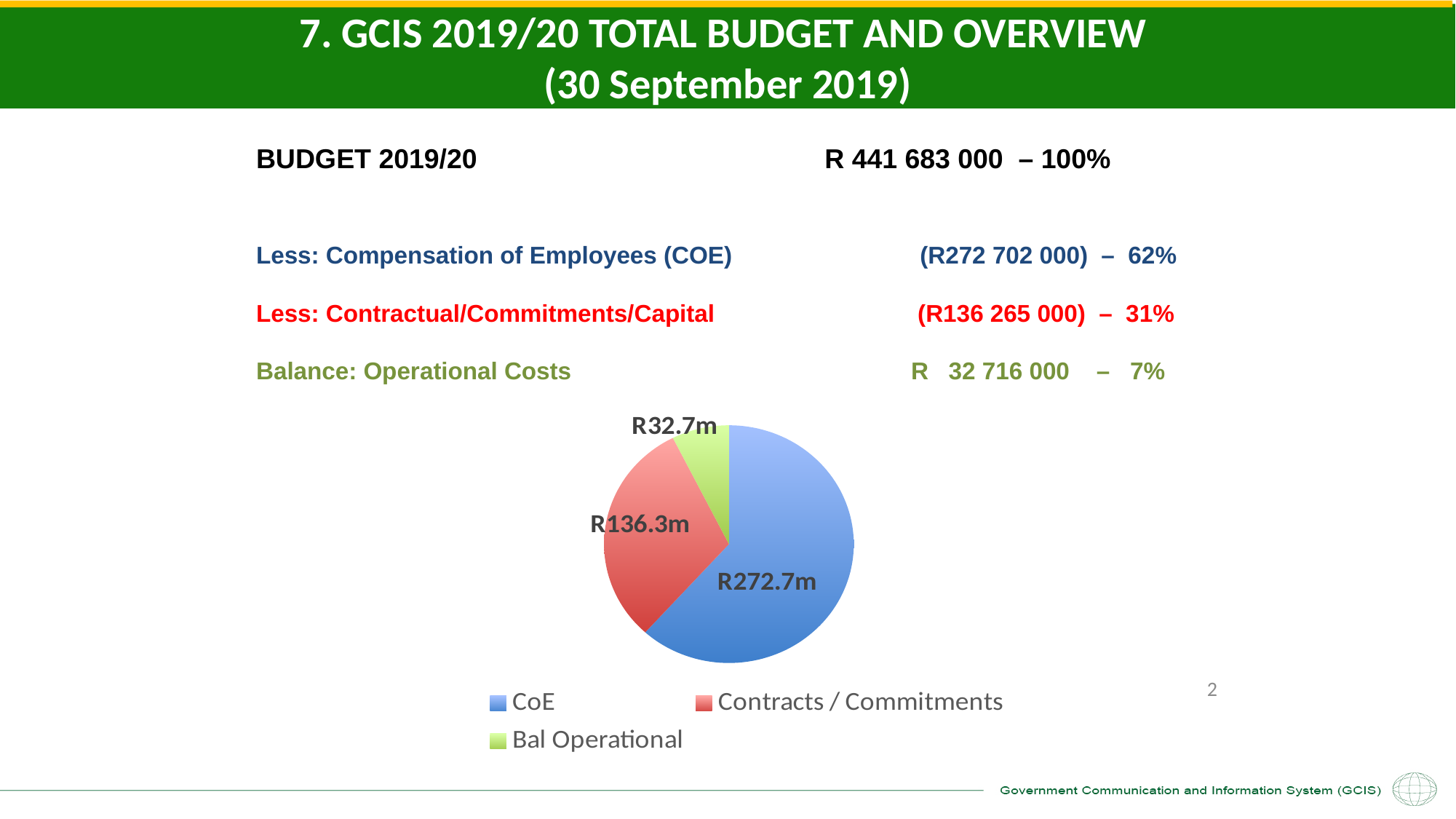
What colour is the CoE slice in the pie chart? Blue What type of chart is shown on the slide? Pie chart How many slices does the pie chart have? 3 Which slice of the pie chart is the largest? CoE What is the difference between the CoE slice and the Contracts / Commitments slice in the pie chart? R136.4m What is the value of the Bal Operational slice in the pie chart? R32.7m Which slice of the pie chart is the smallest? Bal Operational What is the value of the CoE slice in the pie chart? R272.7m What colour is the Bal Operational slice in the pie chart? Green Which is larger in the pie chart, Contracts / Commitments or Bal Operational? Contracts / Commitments What is the value of the Contracts / Commitments slice in the pie chart? R136.3m How many entries does the pie chart's legend list? 3